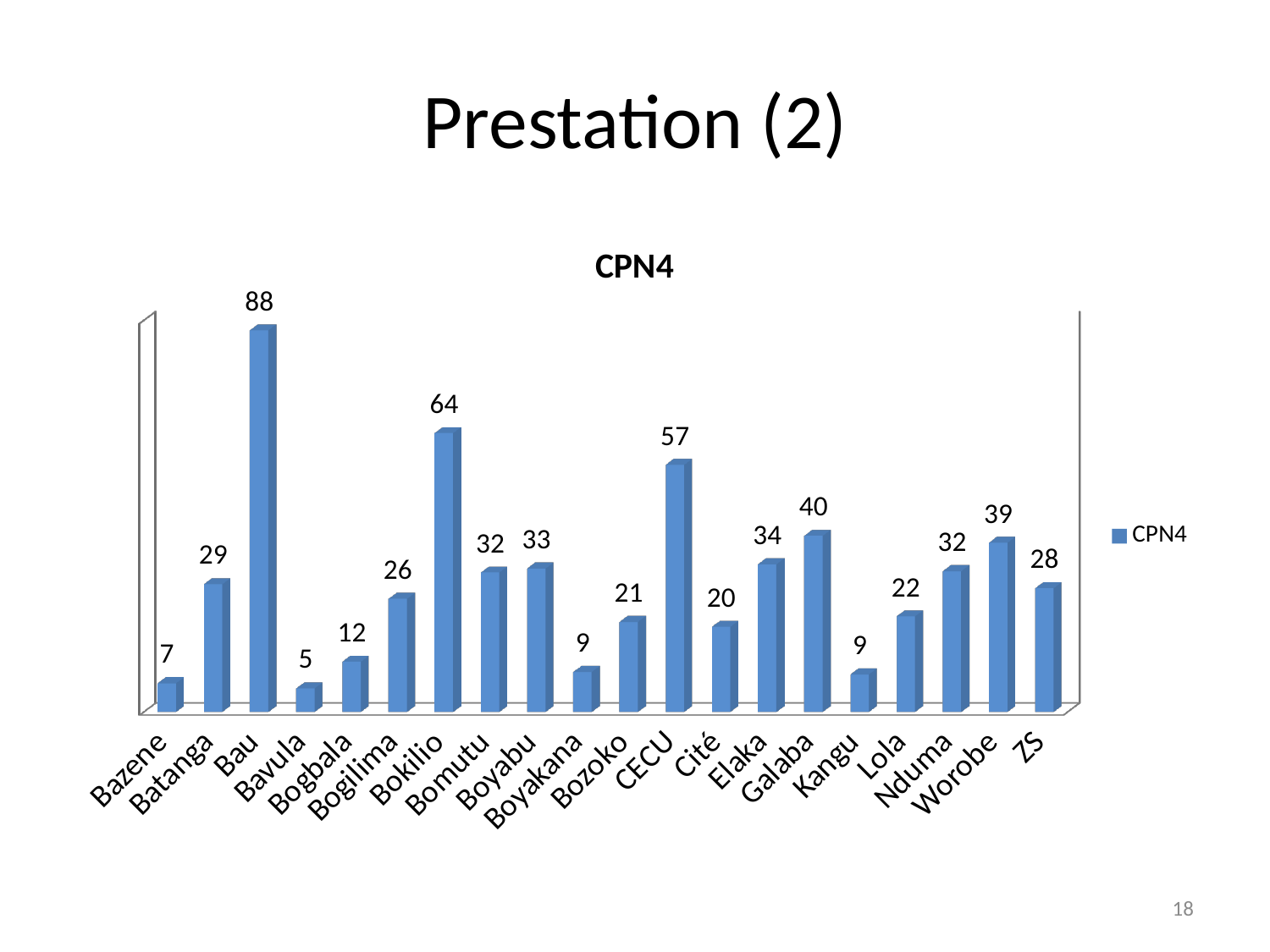
How many categories are shown on the x axis of the chart? 20 What is the CPN4 value for Galaba? 40 How many series does the legend list? 1 What is the CPN4 value for Bokilio? 64 What is the title of the chart? CPN4 What kind of chart is shown on the slide? Bar chart What is the CPN4 value for Bau? 88 What is the difference between the CPN4 values for Bau and CECU? 31 Which category has the lowest CPN4 value? Bavula Which has a larger CPN4 value, Worobe or Elaka? Worobe What is the difference between the CPN4 values for Bokilio and Bozoko? 43 Which category has the highest CPN4 value? Bau